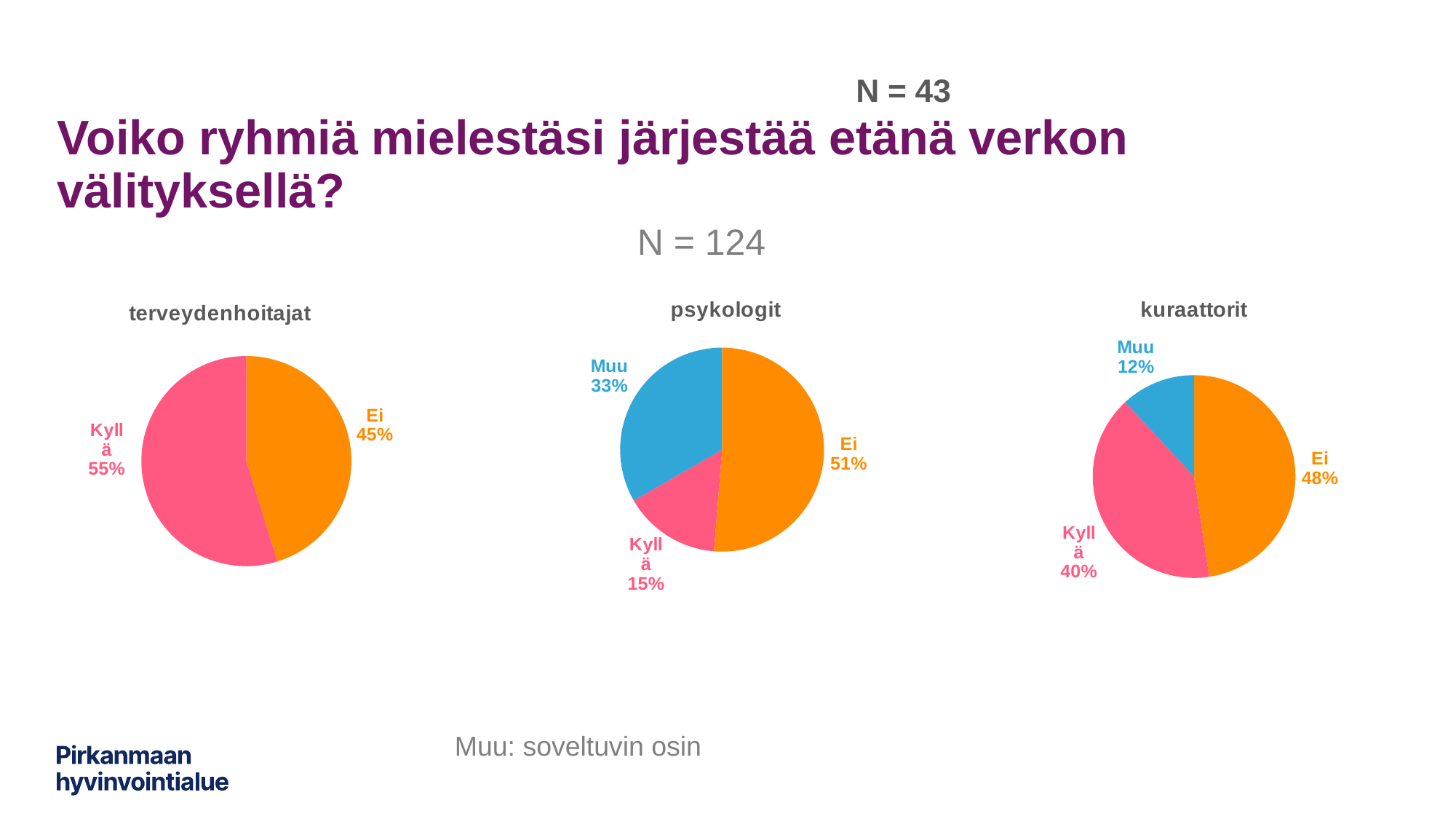
How many slices does the kuraattorit chart have? 3 In the kuraattorit chart, what share of respondents answered Ei? 48% In the psykologit chart, which is larger, the Muu slice or the Kyllä slice? Muu In the terveydenhoitajat chart, what share of respondents answered Ei? 45% In the psykologit chart, what share of respondents answered Kyllä? 15% In the psykologit chart, what share of respondents answered Muu? 33% In the kuraattorit chart, what is the difference in percentage points between Ei and Kyllä? 8 percentage points What kind of chart is the terveydenhoitajat chart? Pie chart In the psykologit chart, which answer has the largest slice? Ei What is the title of the chart on the left of the slide? terveydenhoitajat In the kuraattorit chart, which answer has the smallest slice? Muu In the terveydenhoitajat chart, what share of respondents answered Kyllä? 55%